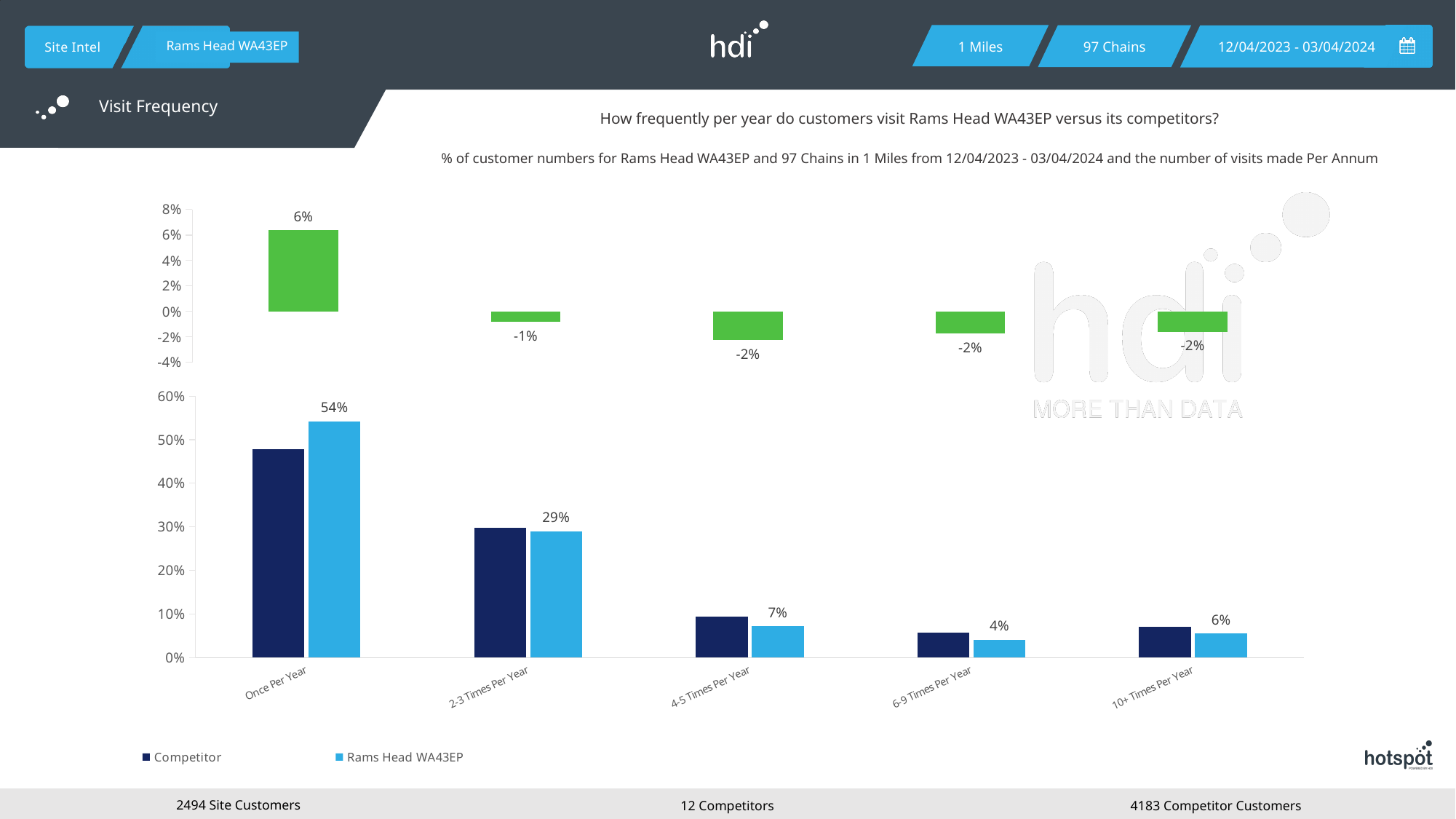
How many categories are shown on the x axis of the bottom chart? 5 In the top chart, which category has the highest value? Once Per Year In the bottom chart, what is the difference between the Rams Head WA43EP values for Once Per Year and 2-3 Times Per Year? 25% In the bottom chart, for Once Per Year, which series has the larger value: Competitor or Rams Head WA43EP? Rams Head WA43EP In the bottom chart, what is the value for Rams Head WA43EP for 6-9 Times Per Year? 4% In the bottom chart, what is the value for Rams Head WA43EP for Once Per Year? 54% In the bottom chart, is the Competitor value for Once Per Year greater or less than 40%? greater In the bottom chart, what is the value for Rams Head WA43EP for 2-3 Times Per Year? 29% In the bottom chart, which category has the lowest value for Rams Head WA43EP? 6-9 Times Per Year In the top chart, what is the value for Once Per Year? 6% In the top chart, what is the value for 2-3 Times Per Year? -1% How many series does the legend of the bottom chart list? 2